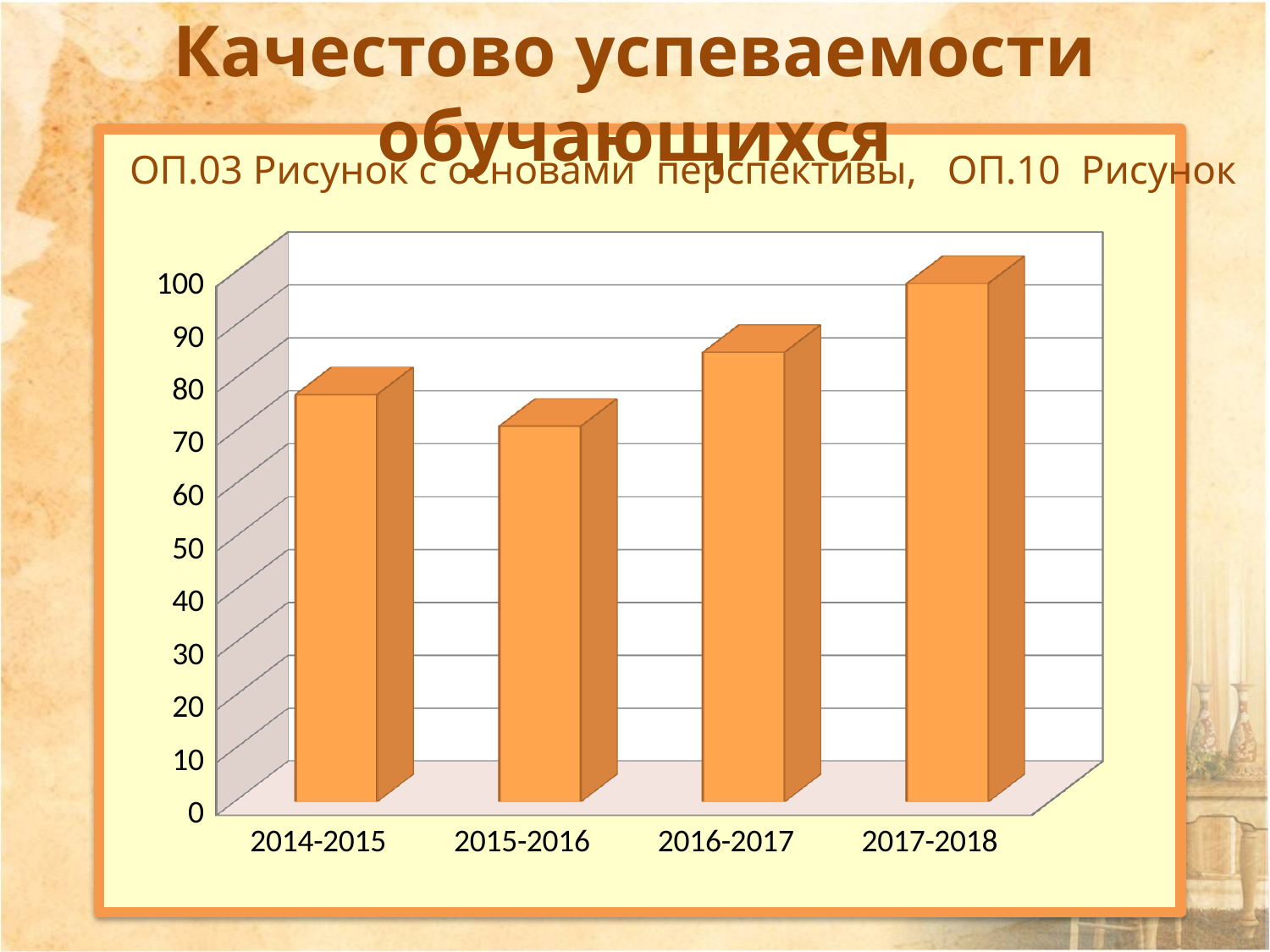
Do the values rise or fall from 2015-2016 to 2017-2018? rise Which academic year has the highest bar in the chart? 2017-2018 Which is larger, the value for 2016-2017 or the value for 2014-2015? 2016-2017 What is the maximum value shown on the vertical axis of the chart? 100 How many academic years are shown on the x axis of the chart? 4 What colour are the bars in the chart? orange Is the value for 2015-2016 greater or less than 80? less Is the value for 2014-2015 greater or less than 70? greater Is the value for 2016-2017 greater or less than 80? greater What kind of chart is shown on the slide? bar chart Which academic year has the lowest bar in the chart? 2015-2016